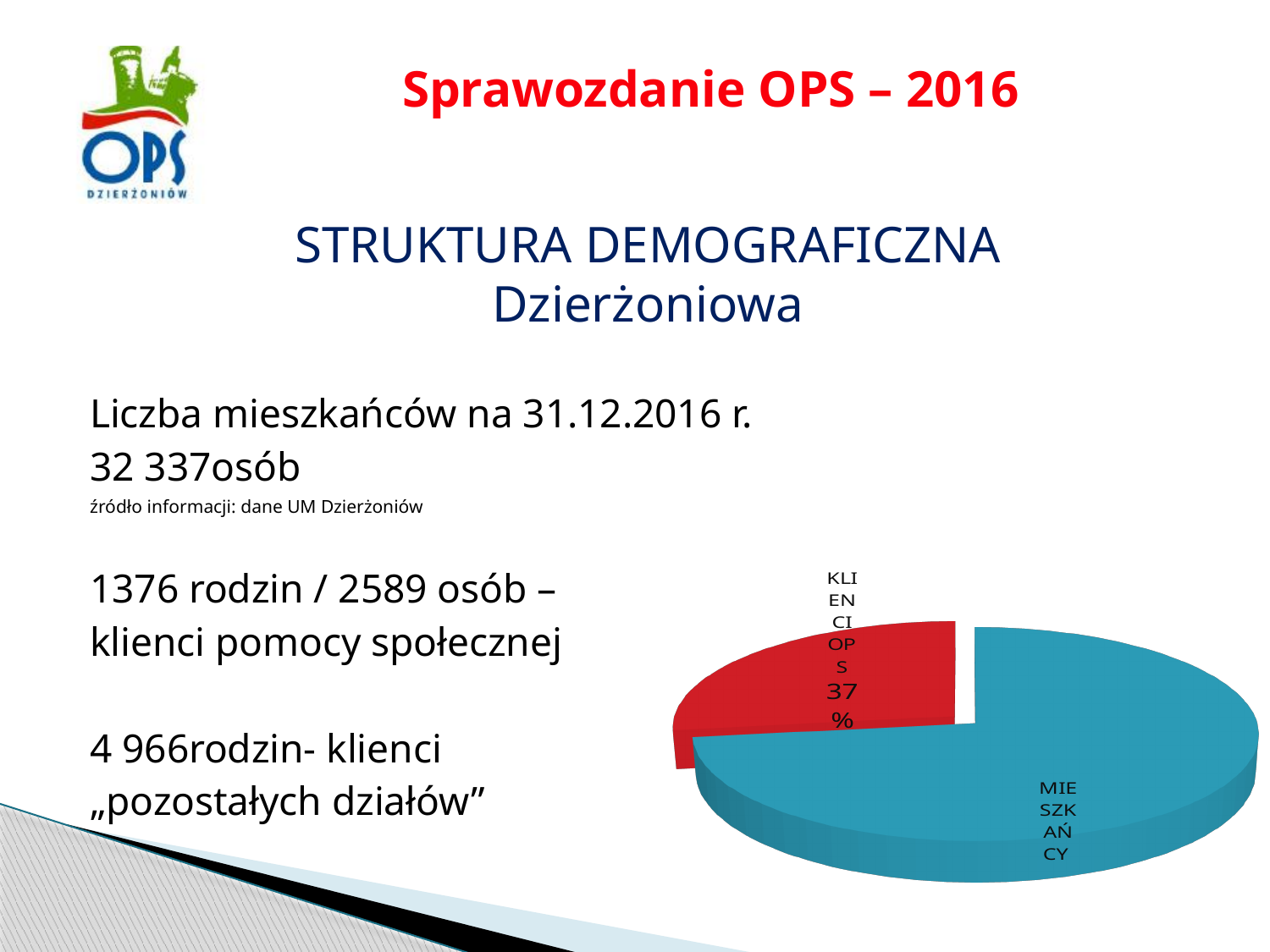
What colour is the MIESZKAŃCY slice in the pie chart? blue How many slices does the pie chart have? 2 What kind of chart is shown on the slide? pie chart What colour is the KLIENCI OPS slice in the pie chart? red What share of the pie does the KLIENCI OPS slice represent? 37% Which slice of the pie chart is the smallest? KLIENCI OPS Which slice is larger, MIESZKAŃCY or KLIENCI OPS? MIESZKAŃCY Which slice of the pie chart is the largest? MIESZKAŃCY